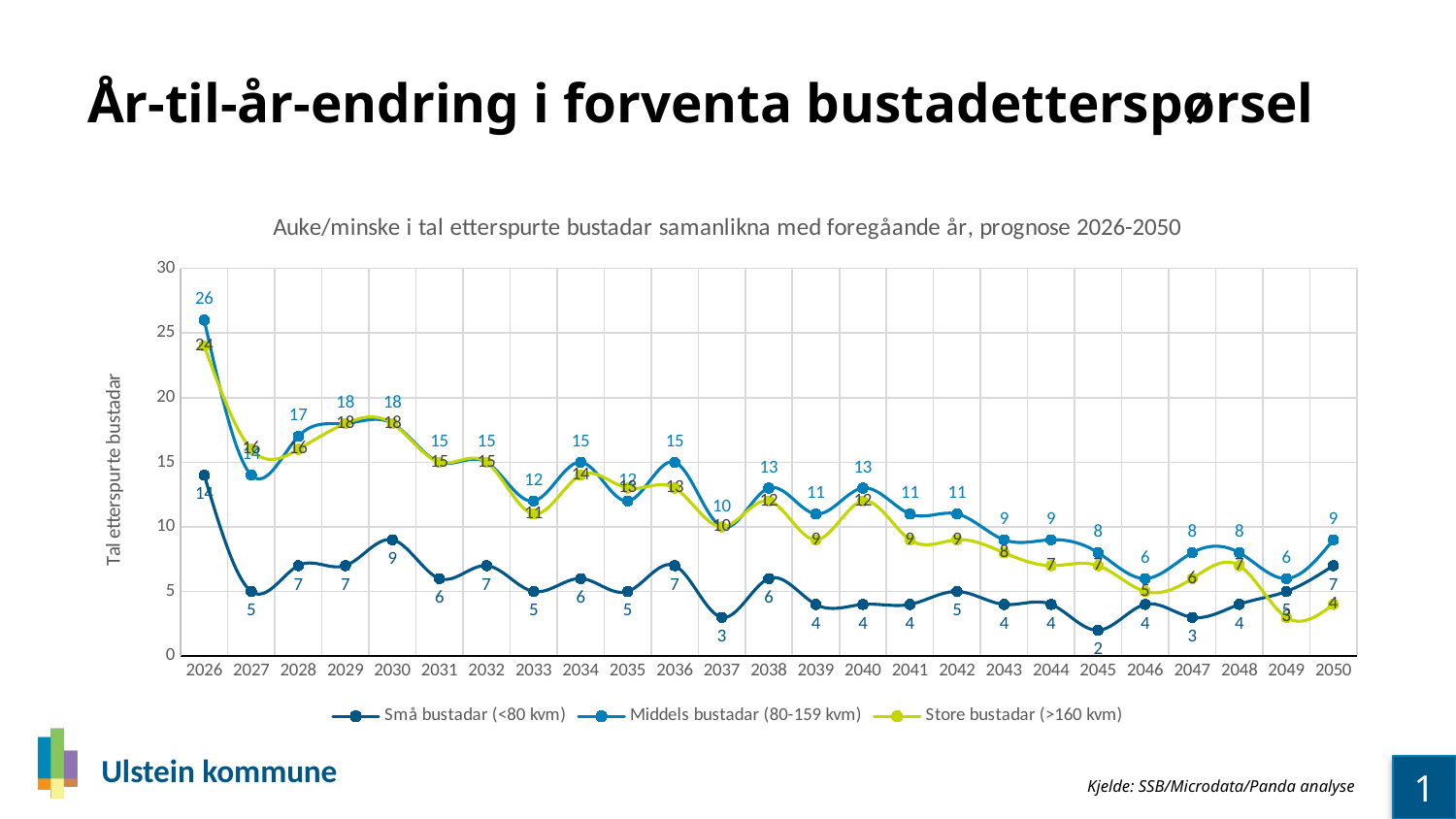
What is the difference between Middels bustadar (80-159 kvm) and Små bustadar (<80 kvm) in 2026? 12 How many series does the legend list? 3 What is the label of the y axis? Tal etterspurte bustadar What is the value for Små bustadar (<80 kvm) in 2045? 2 Which is larger in 2050: Middels bustadar (80-159 kvm) or Store bustadar (>160 kvm)? Middels bustadar (80-159 kvm) How many years are plotted on the x axis? 25 In which year does Middels bustadar (80-159 kvm) reach its highest value? 2026 Does the Store bustadar (>160 kvm) series generally rise or fall from 2026 to 2049? Fall What kind of chart is shown on the slide? Line chart What is the value for Store bustadar (>160 kvm) in 2049? 3 In which year does Små bustadar (<80 kvm) have its lowest value? 2045 What is the value for Middels bustadar (80-159 kvm) in 2026? 26